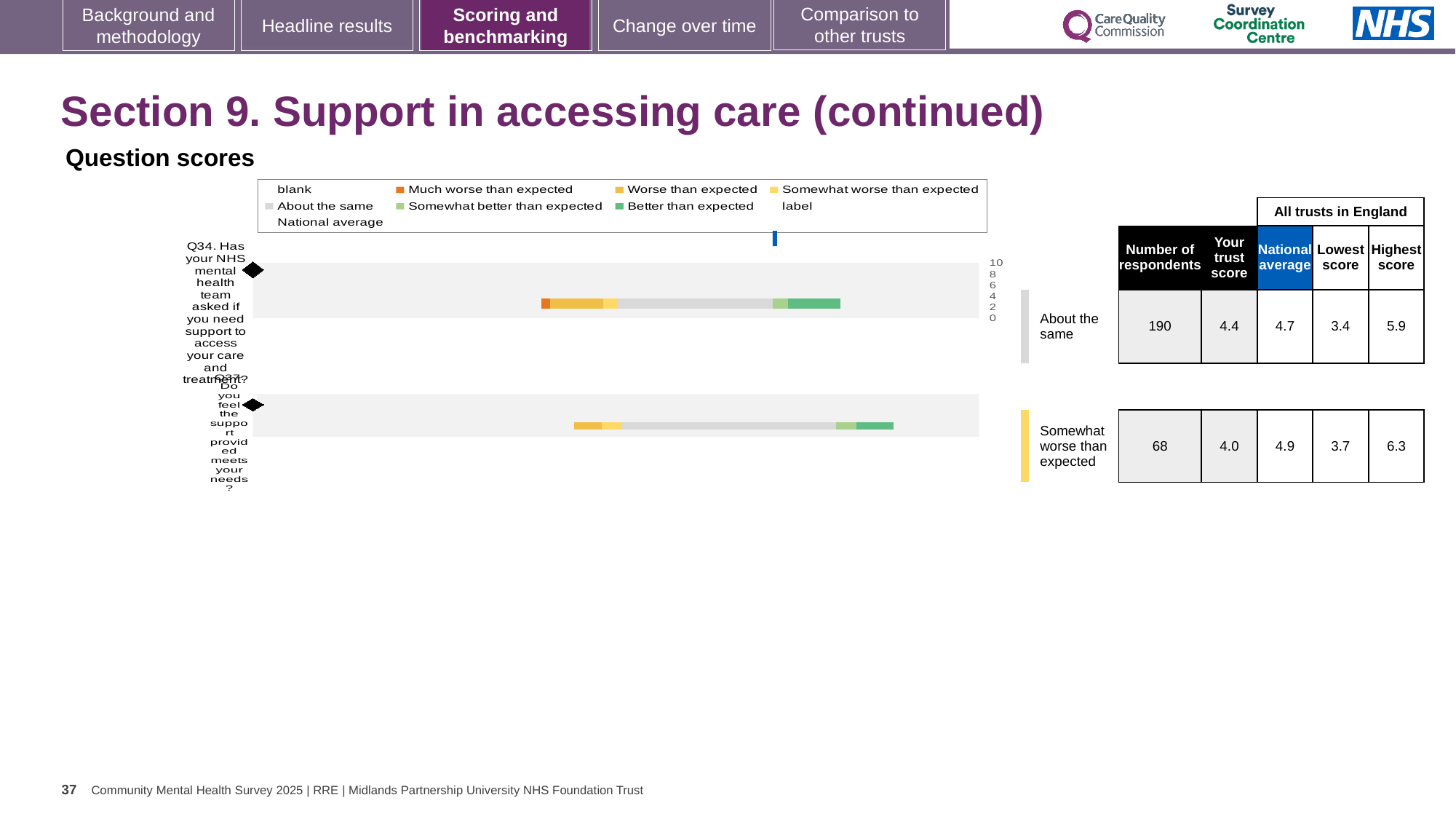
Which benchmark category is shown for Q37 (Do you feel the support provided meets your needs?)? Somewhat worse than expected What is the highest score across all trusts in England for Q37? 6.3 What is the difference between the national average and your trust score for Q37? 0.9 What is the lowest score across all trusts in England for Q34? 3.4 What is the number of respondents for Q34 in the table next to the chart? 190 What is your trust score for Q37 in the table next to the chart? 4.0 Which benchmark category is shown for Q34 (Has your NHS mental health team asked if you need support to access your care and treatment?)? About the same What kind of chart is used to show the question scores on this slide? bar chart What is the national average for Q34 in the table next to the chart? 4.7 How many questions (categories) are plotted in the question scores chart? 2 Which question has the higher trust score, Q34 or Q37? Q34 Which legend entry in the chart is shown in orange? Much worse than expected